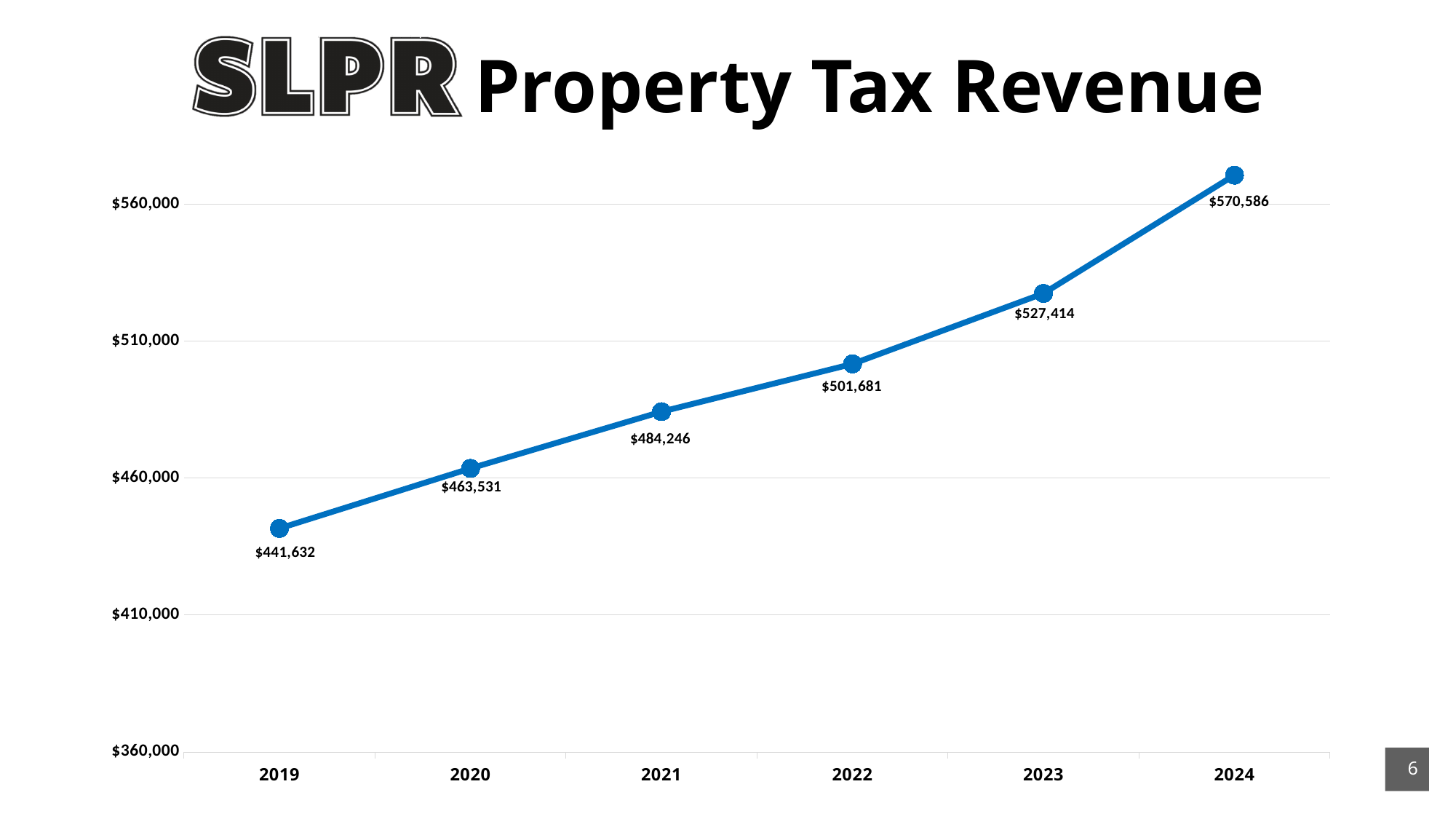
What kind of chart is shown on the slide? line chart Does property tax revenue rise or fall from 2019 to 2024? rise Which year had the highest property tax revenue? 2024 Which year had the lowest property tax revenue? 2019 How many years are plotted on the chart? 6 What was the property tax revenue in 2019? $441,632 What is the difference in property tax revenue between 2024 and 2019? $128,954 What is the difference in property tax revenue between 2021 and 2020? $20,715 What was the property tax revenue in 2024? $570,586 Is the property tax revenue for 2023 greater or less than $510,000? greater What was the property tax revenue in 2022? $501,681 Which year had higher property tax revenue, 2021 or 2023? 2023